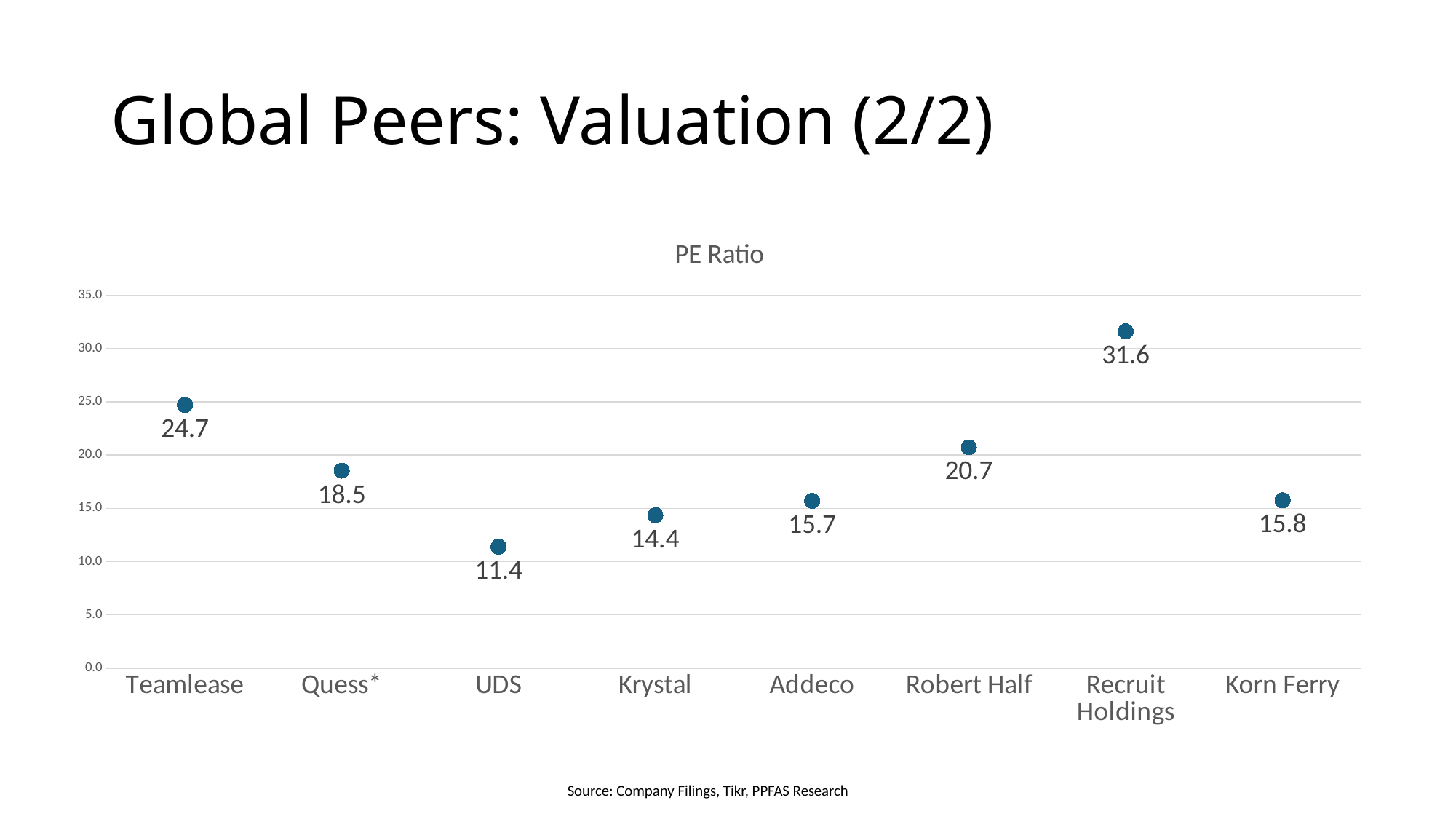
Which company has the highest PE Ratio? Recruit Holdings What is the PE Ratio for Recruit Holdings? 31.6 Which company has the lowest PE Ratio? UDS What is the PE Ratio for UDS? 11.4 What is the PE Ratio for Teamlease? 24.7 How many companies are shown in the PE Ratio chart? 8 What is the difference between the PE Ratio of Recruit Holdings and Teamlease? 6.9 Is the PE Ratio for Addeco greater or less than 20.0? less What is the PE Ratio for Robert Half? 20.7 What is the title of the chart? PE Ratio Which has a higher PE Ratio, Teamlease or Robert Half? Teamlease What is the difference between the PE Ratio of Quess* and Krystal? 4.1